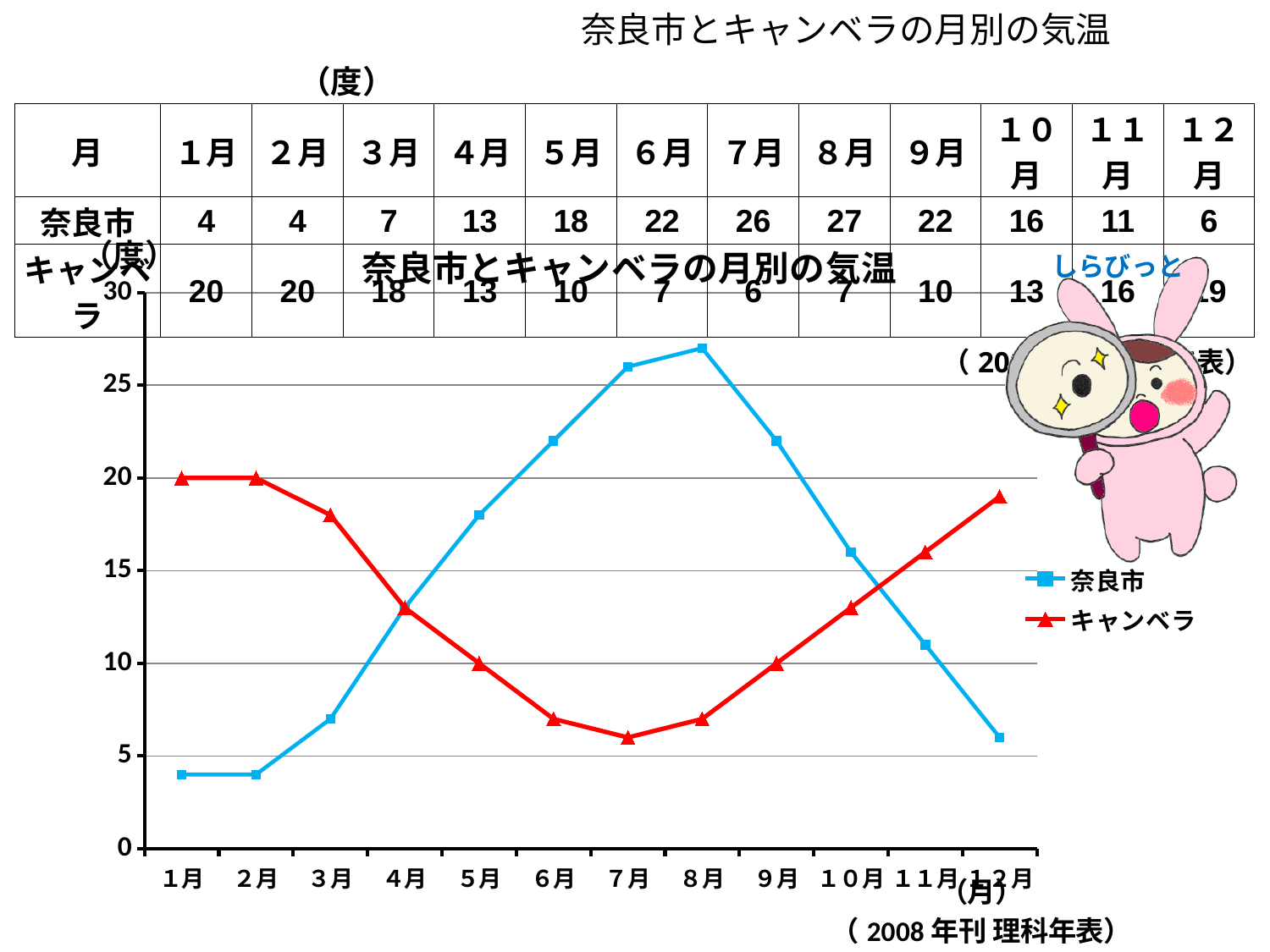
Is the temperature for 奈良市 in 6月 greater or less than 20? greater What is the temperature for 奈良市 in 7月? 26 What is the title of the chart? 奈良市とキャンベラの月別の気温 In 3月, which is higher, the temperature for 奈良市 or for キャンベラ? キャンベラ What is the difference between the 奈良市 and キャンベラ temperatures in 8月? 20 In which month is the temperature for 奈良市 highest? 8月 What kind of chart is shown on the slide? line chart How many months are plotted along the x axis of the chart? 12 What is the temperature for キャンベラ in 1月? 20 Does the 奈良市 line rise or fall from 1月 to 8月? rise How many series does the chart legend list? 2 In which month is the temperature for キャンベラ lowest? 7月